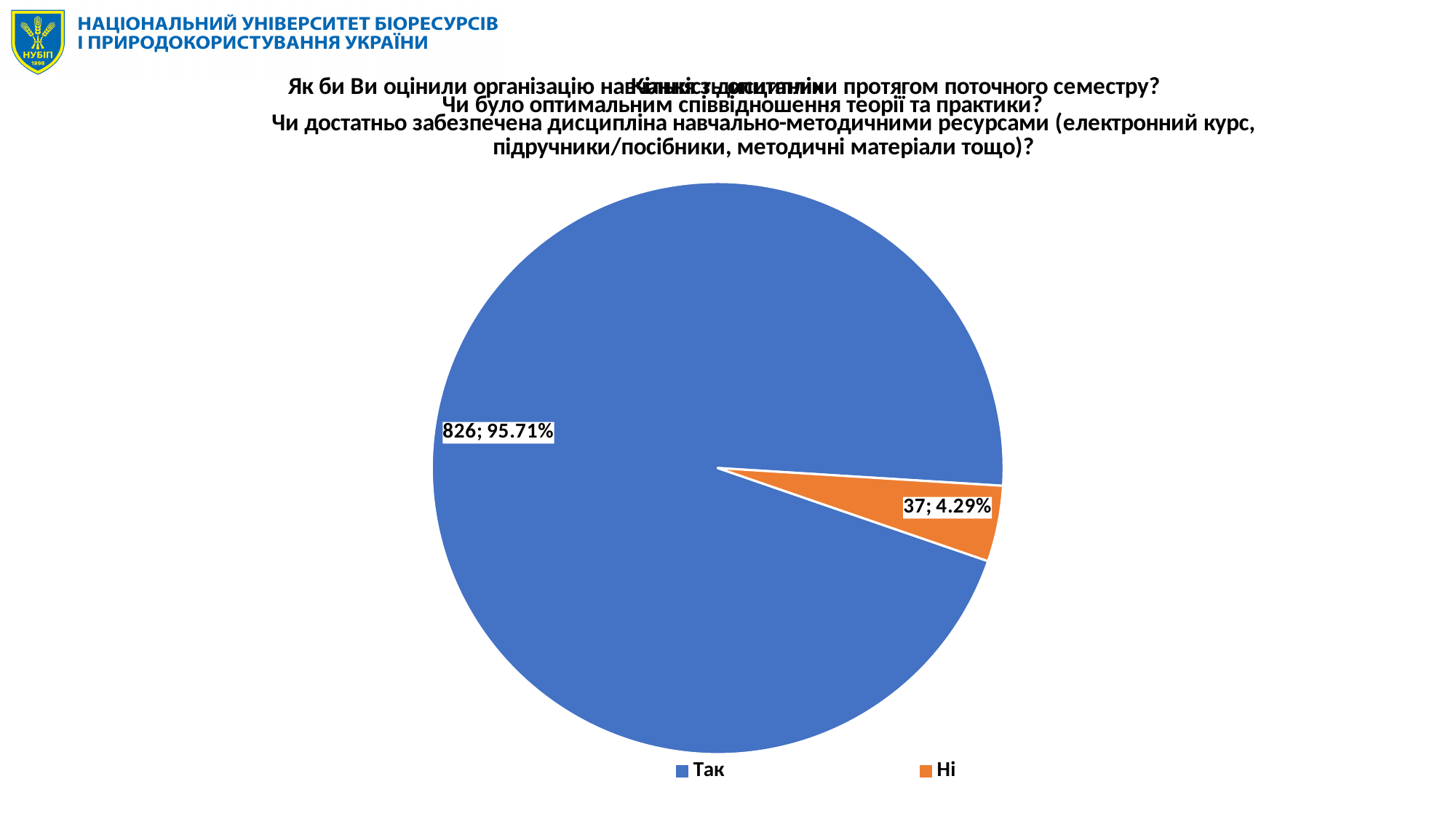
How many categories does the pie chart have? 2 What colour is the "Ні" slice in the pie chart? Orange How many respondents answered "Так" in the pie chart? 826 Which category has the smallest slice in the pie chart? Ні What is the total number of responses shown in the pie chart? 863 What share of the pie does the "Так" slice represent? 95.71% How many respondents answered "Ні" in the pie chart? 37 What is the difference between the counts for "Так" and "Ні"? 789 What type of chart is shown on the slide? Pie chart What share of the pie does the "Ні" slice represent? 4.29% Which category has the largest slice in the pie chart? Так Which is larger, the count for "Так" or the count for "Ні"? Так